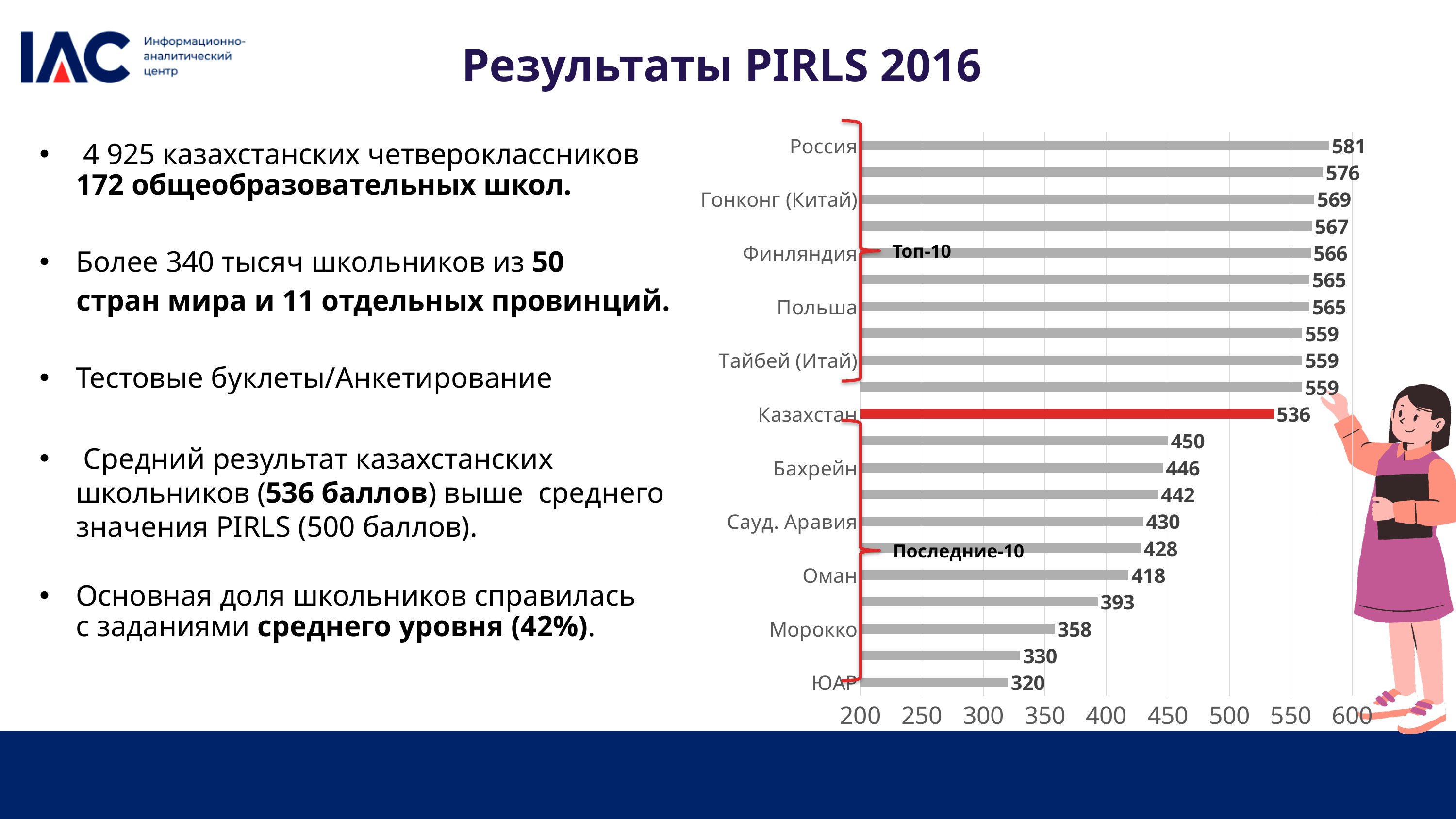
How many bars are plotted in the chart? 21 Which category's bar is coloured red instead of grey? Казахстан Which category has the highest value? Россия Which category has the lowest value? ЮАР Is the value for Морокко greater or less than 400? less Which is larger, the value for Бахрейн or the value for Оман? Бахрейн What is the value for Казахстан? 536 What is the difference between the values for Россия and Казахстан? 45 What is the value for Финляндия? 566 What kind of chart is shown on the slide? bar chart What is the value for Россия? 581 What is the value for ЮАР? 320